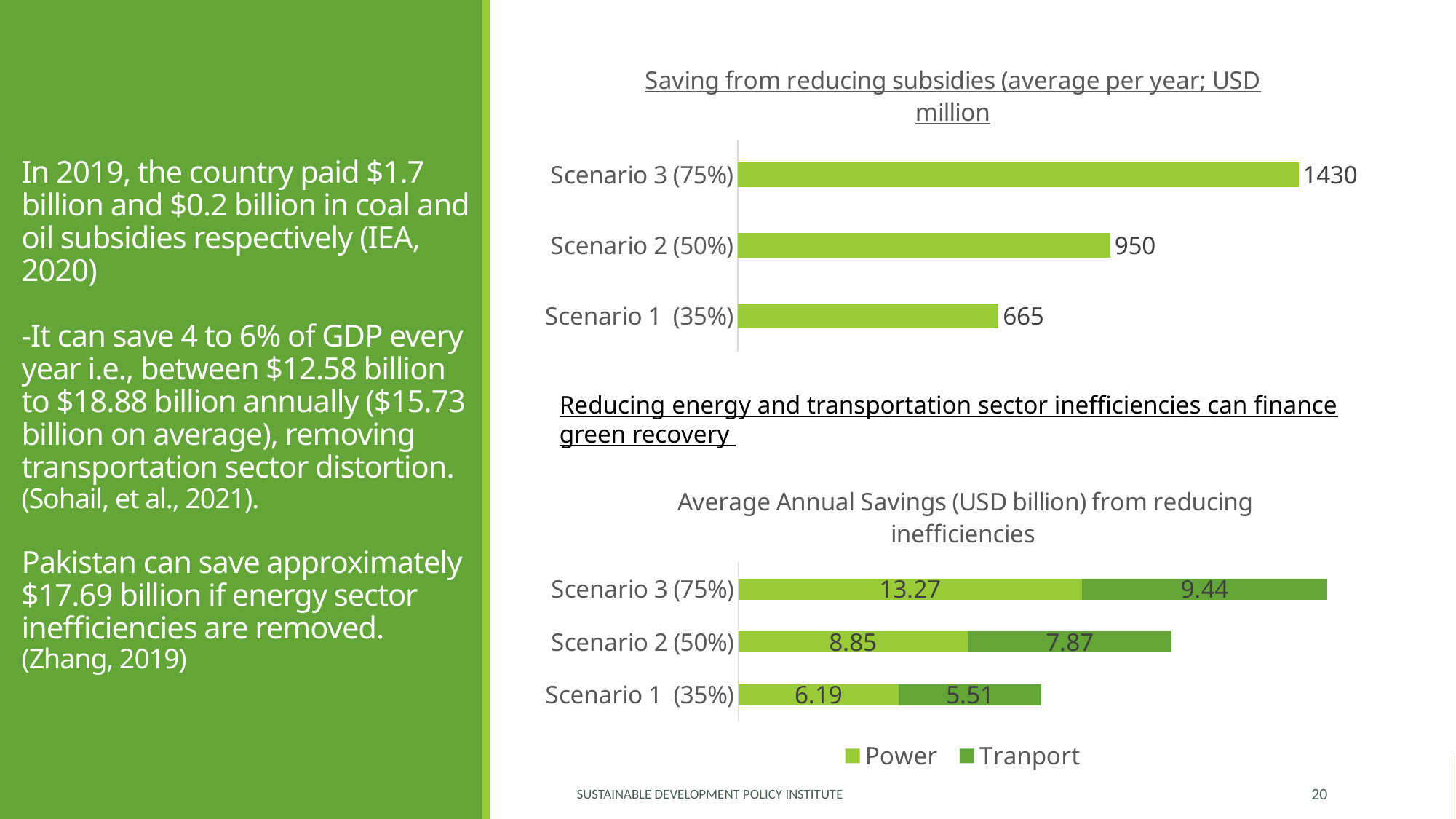
In the top chart, 'Saving from reducing subsidies', how many scenarios are plotted? 3 In the bottom chart, 'Average Annual Savings from reducing inefficiencies', what is the Tranport value for Scenario 1 (35%)? 5.51 In the bottom chart, 'Average Annual Savings from reducing inefficiencies', which series is shown in the darker green? Tranport In the bottom chart, 'Average Annual Savings from reducing inefficiencies', what is the difference between the Power and Tranport values for Scenario 2 (50%)? 0.98 In the top chart, 'Saving from reducing subsidies', which scenario has the highest saving? Scenario 3 (75%) In the top chart, 'Saving from reducing subsidies', what is the value for Scenario 2 (50%)? 950 In the bottom chart, 'Average Annual Savings from reducing inefficiencies', which is larger for Scenario 3 (75%): Power or Tranport? Power What type of chart is the top chart, 'Saving from reducing subsidies'? Bar chart In the bottom chart, 'Average Annual Savings from reducing inefficiencies', what is the Power value for Scenario 2 (50%)? 8.85 In the top chart, 'Saving from reducing subsidies', what is the difference between Scenario 3 (75%) and Scenario 1 (35%)? 765 In the bottom chart, 'Average Annual Savings from reducing inefficiencies', what is the total of the stacked bar for Scenario 3 (75%)? 22.71 In the bottom chart, 'Average Annual Savings from reducing inefficiencies', how many series does the legend list? 2